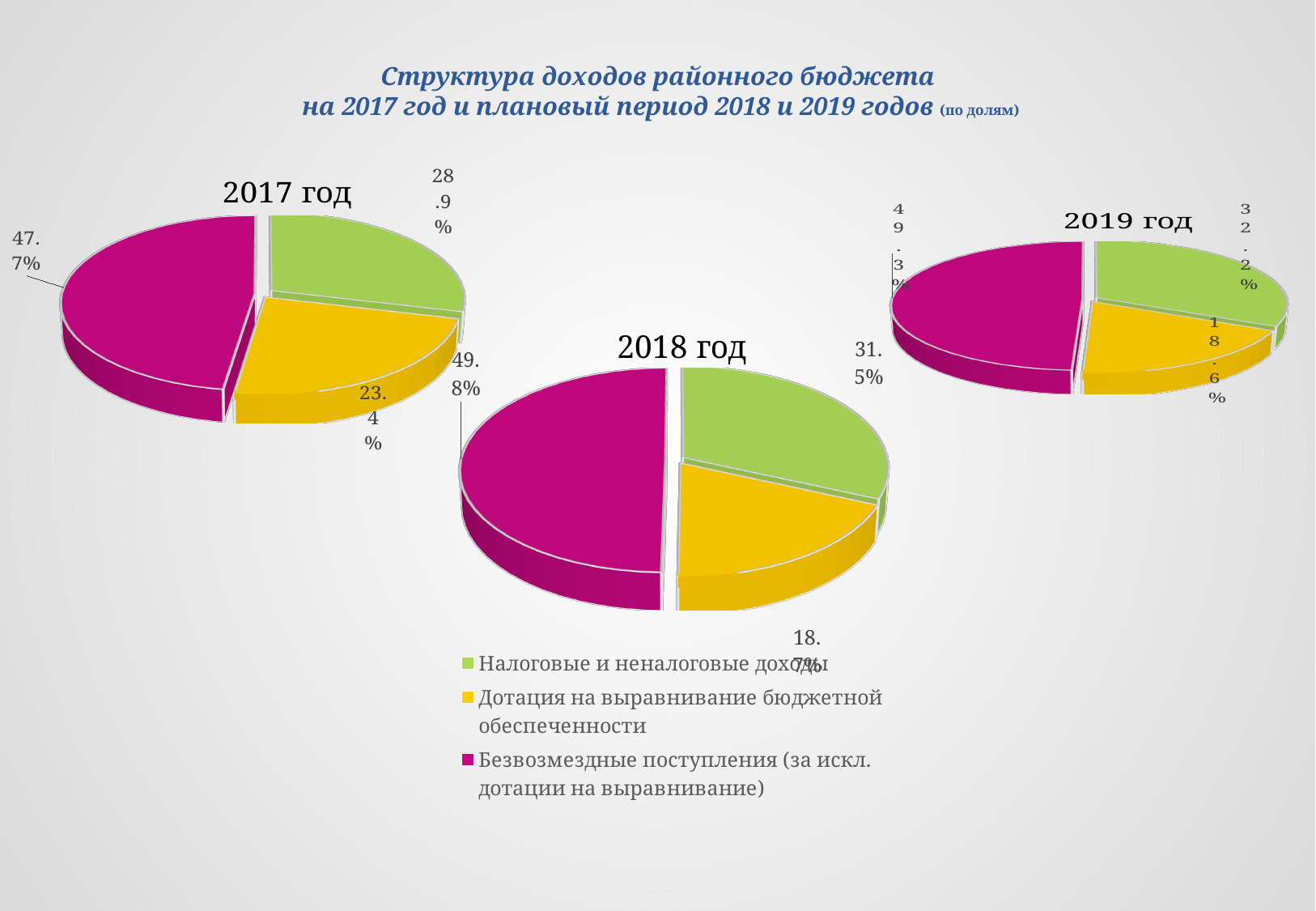
How many charts are on the slide? 3 What type of chart is used for the 2018 год data? Pie chart On the 2017 год chart, what share is shown for Дотация на выравнивание бюджетной обеспеченности? 23.4% On the 2017 год chart, which category has the smallest slice? Дотация на выравнивание бюджетной обеспеченности On the 2017 год chart, what share is shown for Налоговые и неналоговые доходы? 28.9% On the 2019 год chart, which category has the largest slice? Безвозмездные поступления (за искл. дотации на выравнивание) On the 2018 год chart, what is the difference between the shares of Безвозмездные поступления and Налоговые и неналоговые доходы? 18.3% On the 2018 год chart, what share is shown for Налоговые и неналоговые доходы? 31.5% On the 2019 год chart, which is larger: the share of Налоговые и неналоговые доходы or the share of Дотация на выравнивание бюджетной обеспеченности? Налоговые и неналоговые доходы On the 2018 год chart, what share is shown for Безвозмездные поступления (за искл. дотации на выравнивание)? 49.8% On the 2017 год chart, what share is shown for Безвозмездные поступления (за искл. дотации на выравнивание)? 47.7% On the 2019 год chart, what share is shown for Дотация на выравнивание бюджетной обеспеченности? 18.6%